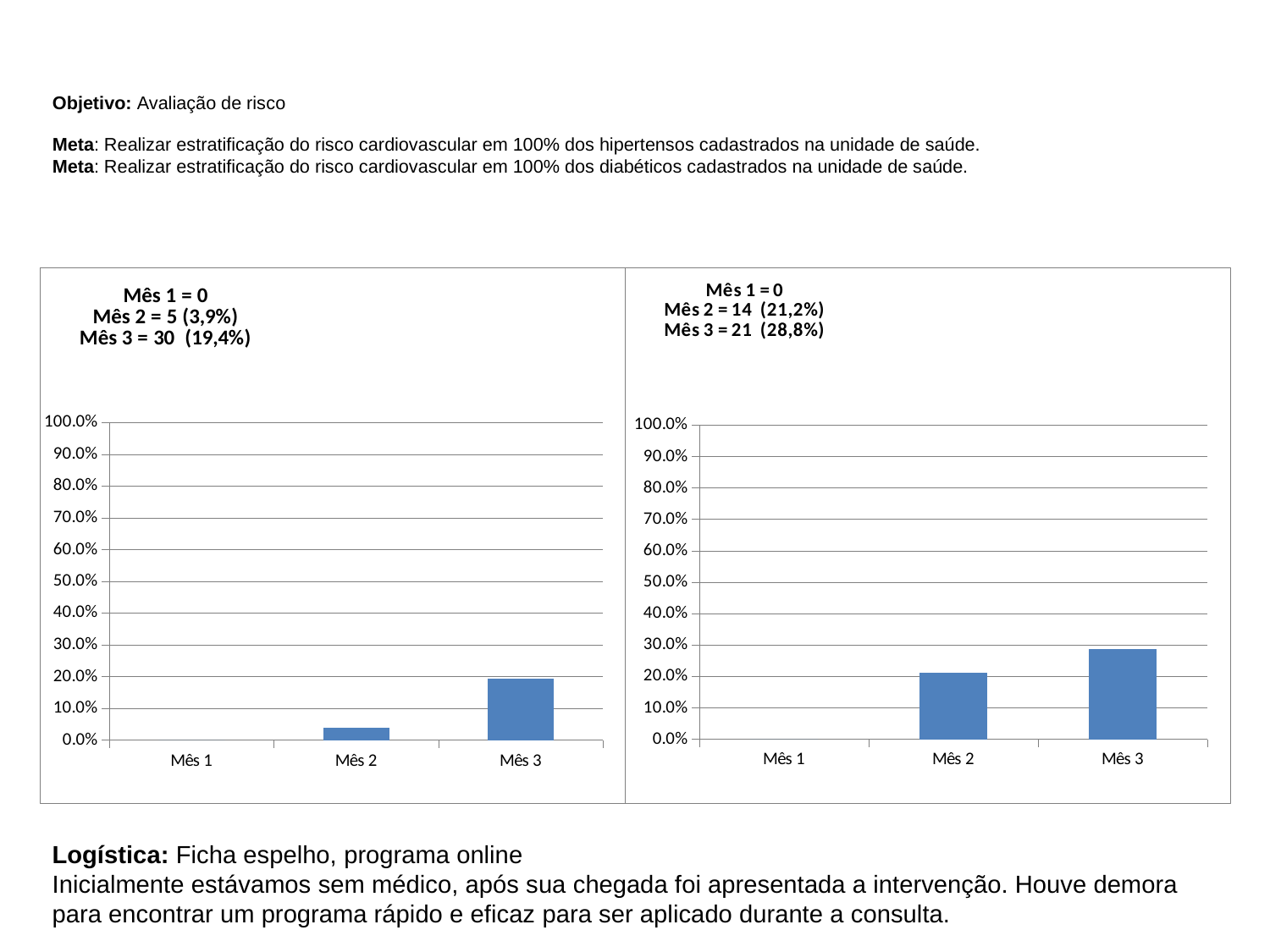
In the right chart, what percentage is given for Mês 3? 28,8% In the left chart, which month has the highest value? Mês 3 In the right chart, do the values rise or fall from Mês 1 to Mês 3? rise In the right chart, which month has the highest value? Mês 3 In the left chart, is the value for Mês 3 greater or less than 30.0%? less In the left chart, what percentage is given for Mês 2? 3,9% In the left chart, what percentage is given for Mês 3? 19,4% In the left chart, what is the value for Mês 1? 0 In the right chart, what percentage is given for Mês 2? 21,2% What kind of chart is the left chart? bar chart How many categories are shown on the x axis of the left chart? 3 Which is larger: the Mês 3 value in the left chart or the Mês 3 value in the right chart? the right chart